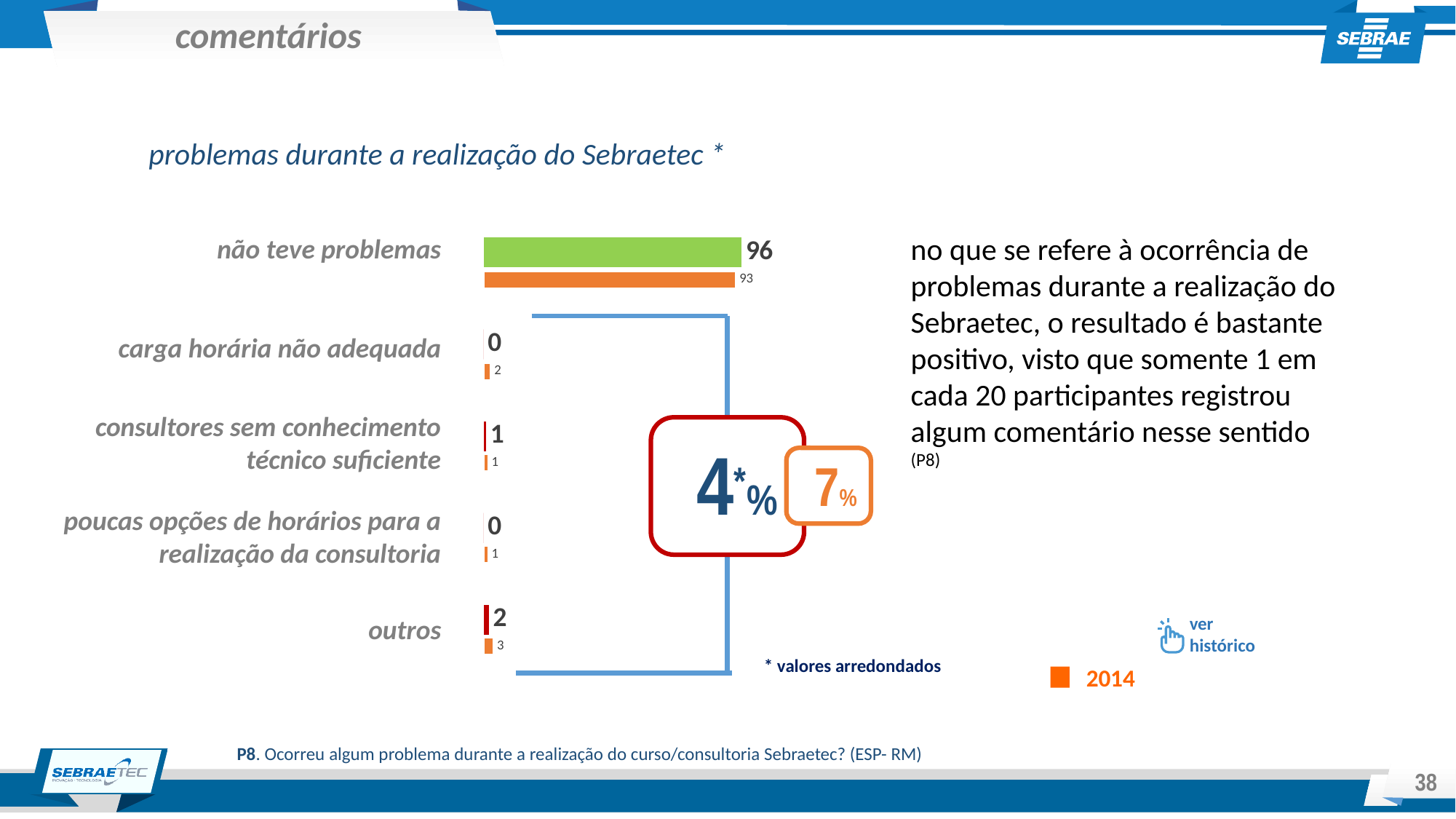
For 'outros', which is larger: the top bar value or the 2014 (orange) value? the 2014 (orange) value What is the value of the top (green) bar for 'não teve problemas'? 96 Which year does the orange series in the legend represent? 2014 What is the 2014 (orange) value for 'não teve problemas'? 93 How many categories does the bar chart show? 5 What is the value of the top bar for 'consultores sem conhecimento técnico suficiente'? 1 Which category has the highest value in the 2014 (orange) series? não teve problemas What is the 2014 (orange) value for 'outros'? 3 What is the value of the top bar for 'outros'? 2 What is the 2014 (orange) value for 'carga horária não adequada'? 2 What is the difference between the top bar value (96) and the 2014 value (93) for 'não teve problemas'? 3 What kind of chart is shown on the slide? bar chart